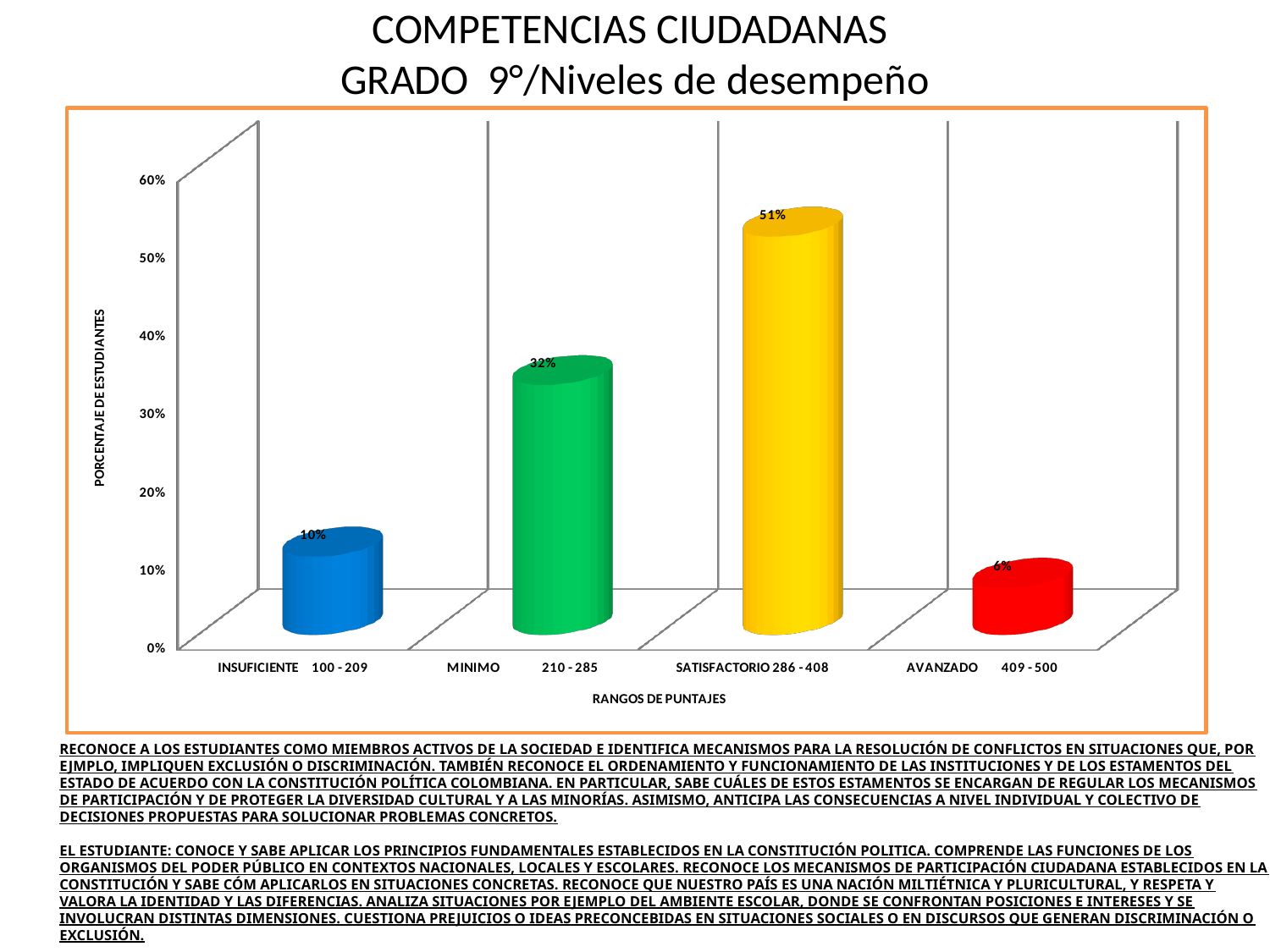
What percentage of students is shown for the MINIMO (210 - 285) level? 32% Is the value for MINIMO greater or less than 30%? greater How many performance levels are shown on the x axis? 4 Which level has a larger percentage of students, INSUFICIENTE or AVANZADO? INSUFICIENTE Which performance level has the lowest percentage of students? AVANZADO 409 - 500 What is the label of the vertical axis? PORCENTAJE DE ESTUDIANTES What percentage of students is shown for the AVANZADO (409 - 500) level? 6% What kind of chart is shown on the slide? Bar chart What is the difference in percentage points between the SATISFACTORIO and MINIMO levels? 19 What percentage of students is shown for the INSUFICIENTE (100 - 209) level? 10% Which performance level has the highest percentage of students? SATISFACTORIO 286 - 408 What percentage of students is shown for the SATISFACTORIO (286 - 408) level? 51%